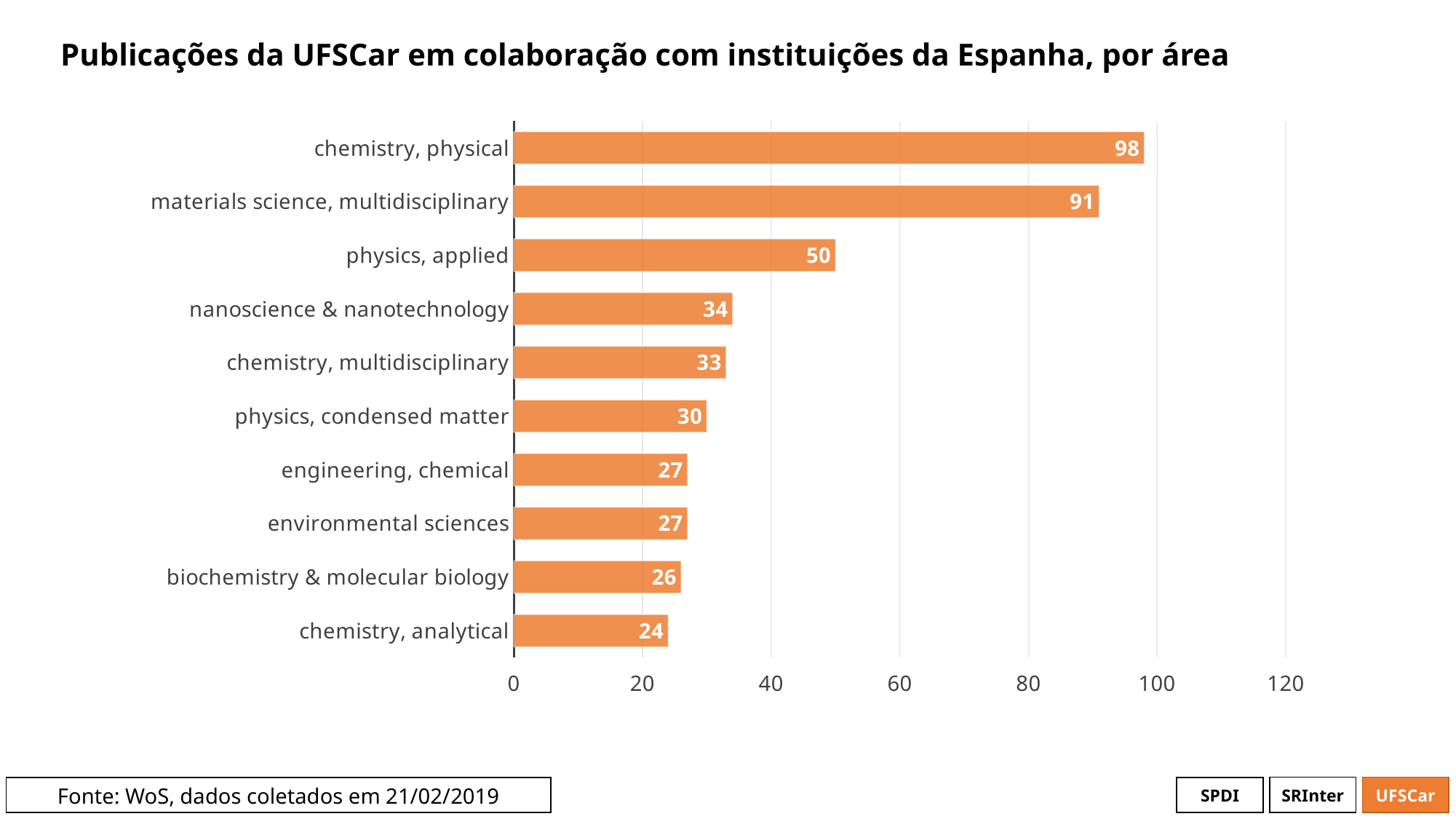
What is the difference between the values for chemistry, physical and materials science, multidisciplinary? 7 How many areas are shown in the chart? 10 What is the value for chemistry, physical? 98 What is the title of the chart? Publicações da UFSCar em colaboração com instituições da Espanha, por área What is the value for biochemistry & molecular biology? 26 What is the value for physics, applied? 50 Which area has the highest value? chemistry, physical What kind of chart is shown on the slide? bar chart Which area has the lowest value? chemistry, analytical Is the value for materials science, multidisciplinary greater or less than 80? greater What is the difference between the values for physics, applied and nanoscience & nanotechnology? 16 Which is larger, the value for physics, condensed matter or the value for engineering, chemical? physics, condensed matter